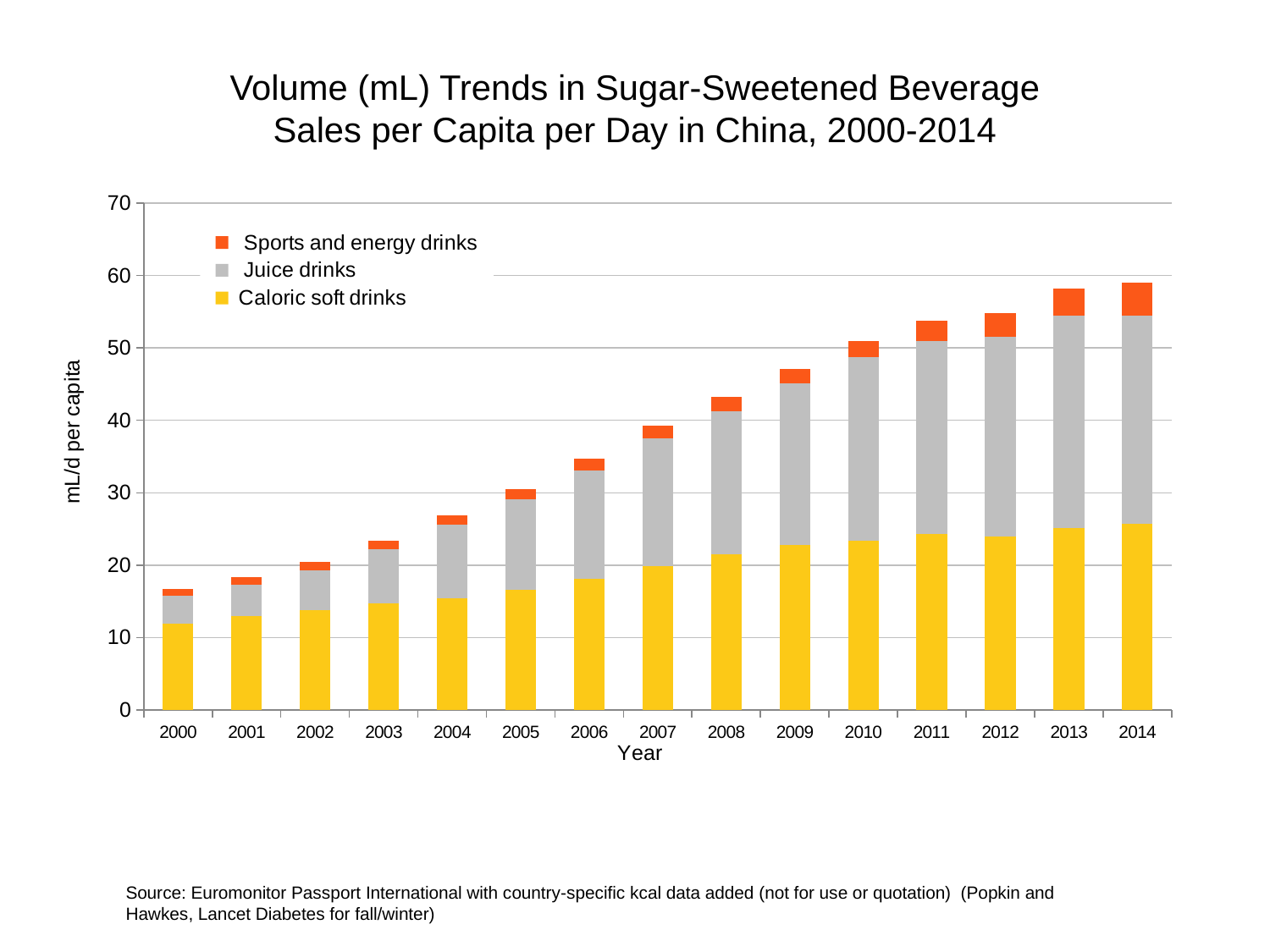
How many years are shown along the x axis? 15 How many series does the legend list? 3 Is the total value for 2008 greater or less than 40? greater In 2014, which segment is larger: Juice drinks or Sports and energy drinks? Juice drinks Is the total value for 2000 greater or less than 20? less What kind of chart is shown on the slide? Stacked bar chart Which series is shown in yellow in the legend? Caloric soft drinks Which year has the highest total sugar-sweetened beverage volume? 2014 Is the Caloric soft drinks value for 2014 greater or less than 20? greater Which year has the lowest total sugar-sweetened beverage volume? 2000 Do the total bar heights rise or fall from 2000 to 2014? Rise